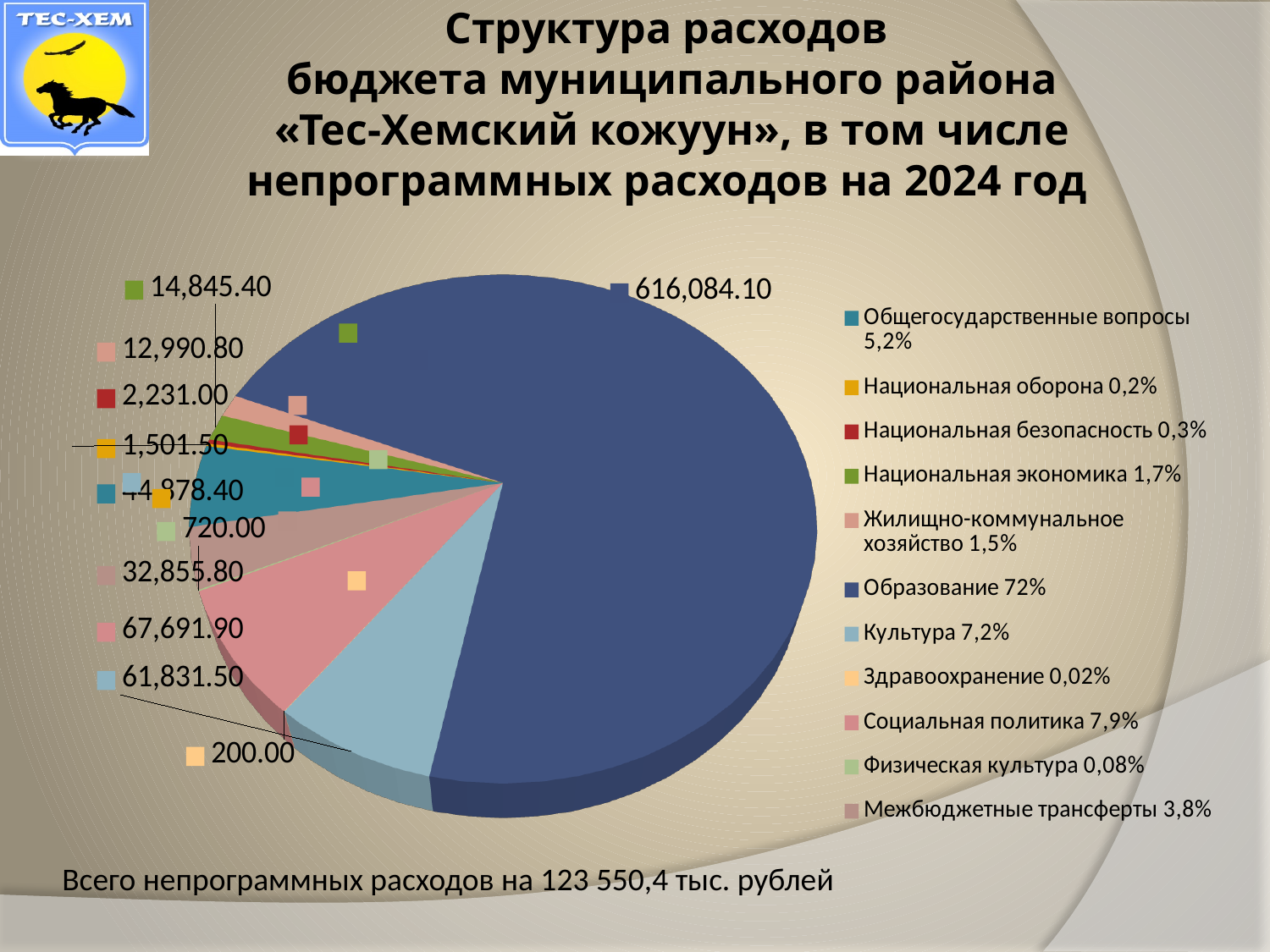
Which is larger, the value for Социальная политика or the value for Культура? Социальная политика Which category has the smallest slice of the pie? Здравоохранение What is the value shown for Образование? 616,084.10 What is the value shown for Физическая культура? 720.00 How many categories (slices) does the pie chart have? 11 What share of the pie does Межбюджетные трансферты account for, according to the legend? 3,8% What share of the pie does Образование account for, according to the legend? 72% What kind of chart is shown on the slide? pie chart What is the value shown for Социальная политика? 67,691.90 What is the difference between the values for Социальная политика and Культура? 5,860.40 Which category has the largest slice of the pie? Образование What is the value shown for Культура? 61,831.50